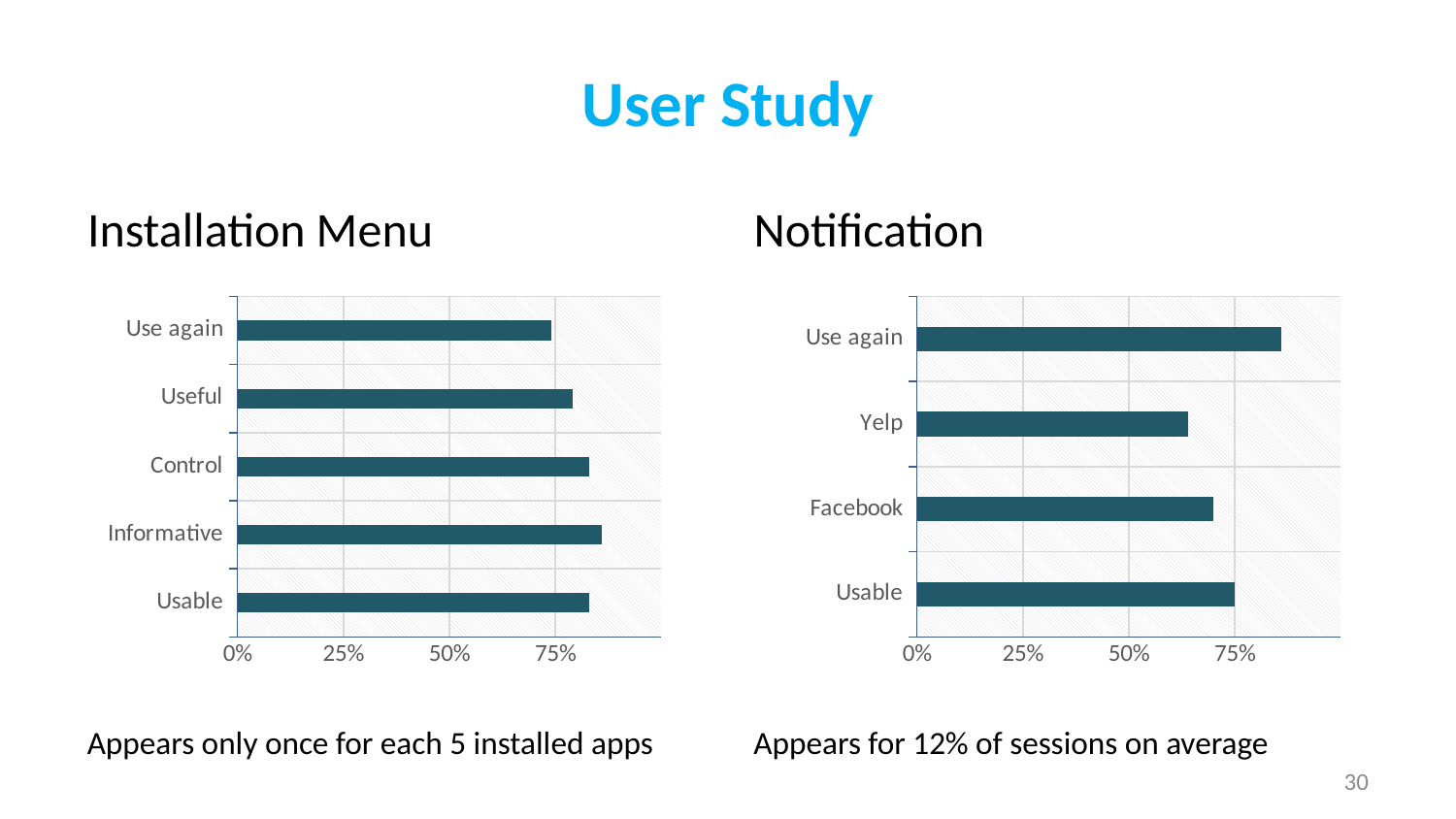
In the Notification chart, is the value for Facebook greater or less than 75%? less In the Notification chart, which is larger, the value for Facebook or the value for Yelp? Facebook In the Notification chart, is the value for Use again greater or less than 75%? greater How many categories does the Installation Menu chart show? 5 How many categories does the Notification chart show? 4 What kind of chart is the Installation Menu chart? bar chart In the Notification chart, which category has the lowest value? Yelp In the Installation Menu chart, which is larger, the value for Control or the value for Use again? Control In the Installation Menu chart, is the value for Control greater or less than 75%? greater In the Notification chart, which category has the highest value? Use again In the Installation Menu chart, which category has the highest value? Informative In the Installation Menu chart, which category has the lowest value? Use again